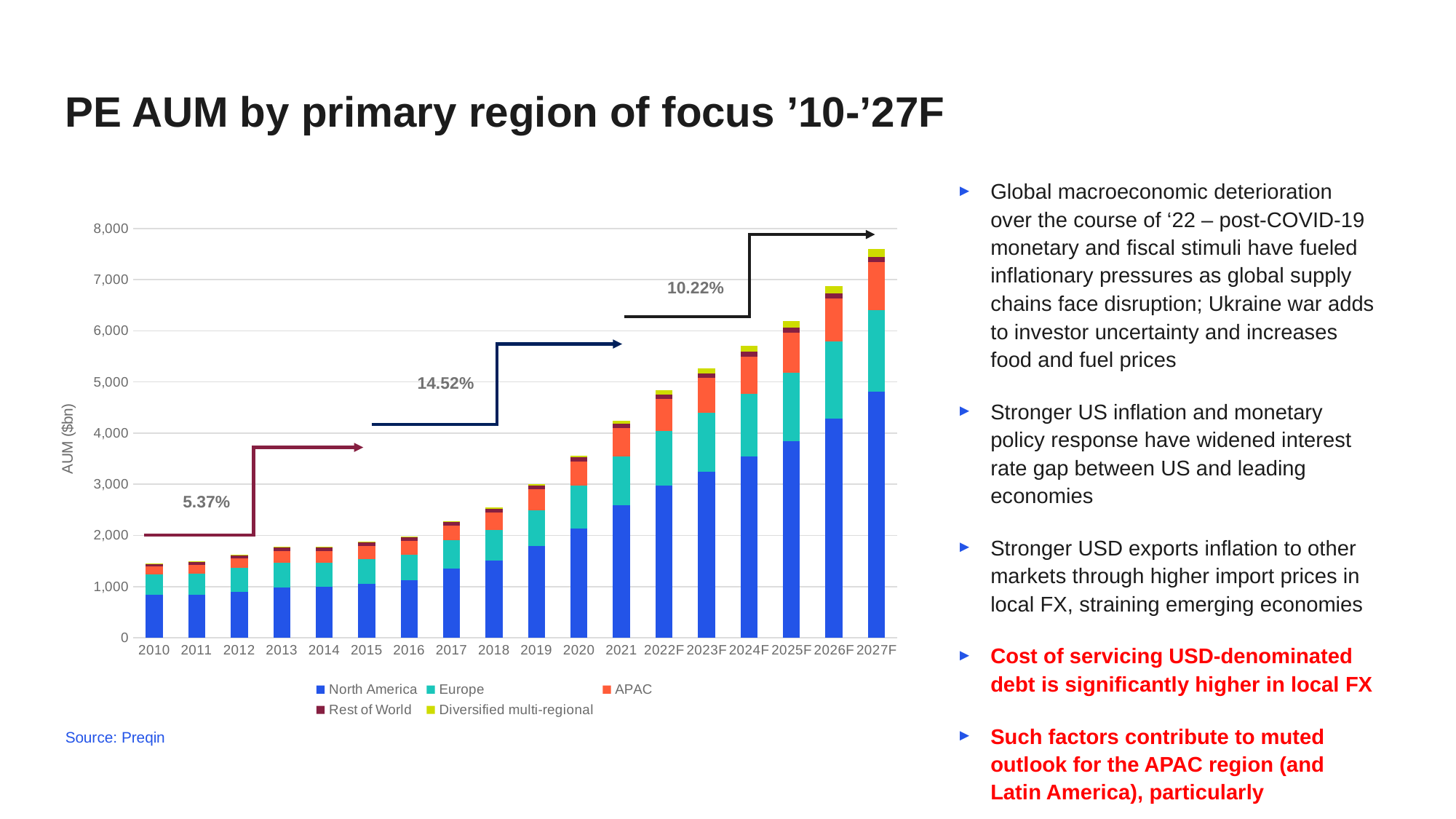
How many series does the legend list? 5 What growth rate is annotated for the period starting in 2015? 14.52% Is the total AUM for 2015 greater or less than 2,000? less Is the North America value for 2027F greater or less than 4,000? greater How many years (categories) are shown on the x axis? 18 Is the total AUM for 2027F greater or less than 7,000? greater Which year has the highest total PE AUM? 2027F What growth rate is annotated for the earliest period (2010 onward)? 5.37% What is the label on the y axis of the chart? AUM ($bn) Which is larger in 2027F, the North America segment or the Europe segment? North America Do total PE AUM values generally rise or fall from 2010 to 2027F? Rise What type of chart is shown on the slide? Stacked bar chart